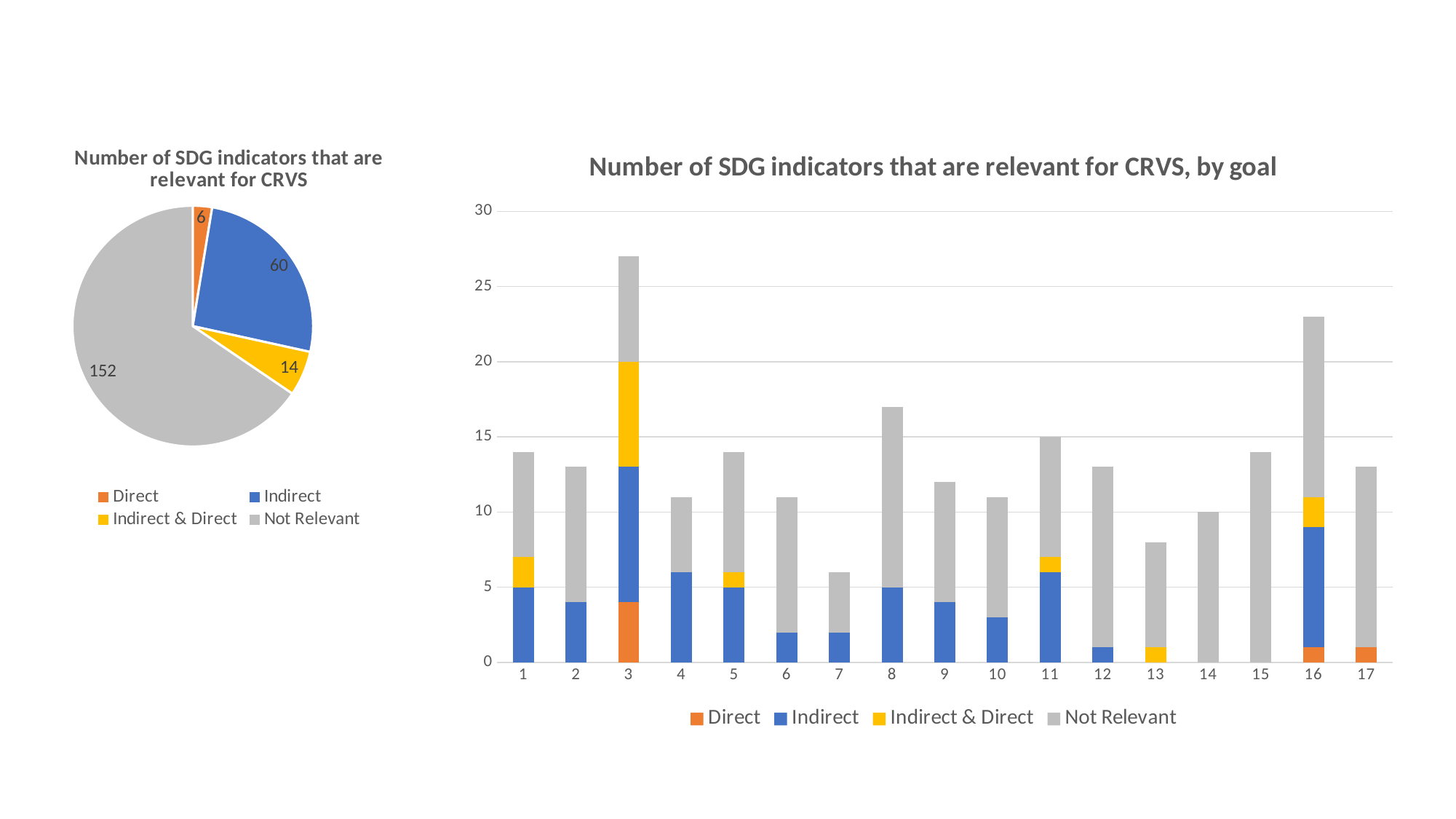
In the bar chart 'Number of SDG indicators that are relevant for CRVS, by goal', which goal has the tallest stacked bar? 3 In the pie chart 'Number of SDG indicators that are relevant for CRVS', what is the value for Indirect? 60 In the bar chart 'Number of SDG indicators that are relevant for CRVS, by goal', how many goals are shown on the x axis? 17 In the pie chart 'Number of SDG indicators that are relevant for CRVS', which category has the largest value? Not Relevant In the bar chart 'Number of SDG indicators that are relevant for CRVS, by goal', is the total for goal 7 greater or less than 10? less In the pie chart 'Number of SDG indicators that are relevant for CRVS', what is the difference between the Indirect and Indirect & Direct values? 46 In the bar chart 'Number of SDG indicators that are relevant for CRVS, by goal', is the total for goal 16 greater or less than 20? greater In the pie chart 'Number of SDG indicators that are relevant for CRVS', what is the value for Not Relevant? 152 In the pie chart 'Number of SDG indicators that are relevant for CRVS', what is the total of all four slices? 232 In the pie chart 'Number of SDG indicators that are relevant for CRVS', what is the value for Indirect & Direct? 14 In the pie chart 'Number of SDG indicators that are relevant for CRVS', which category has the smallest value? Direct In the bar chart 'Number of SDG indicators that are relevant for CRVS, by goal', how many series does the legend list? 4